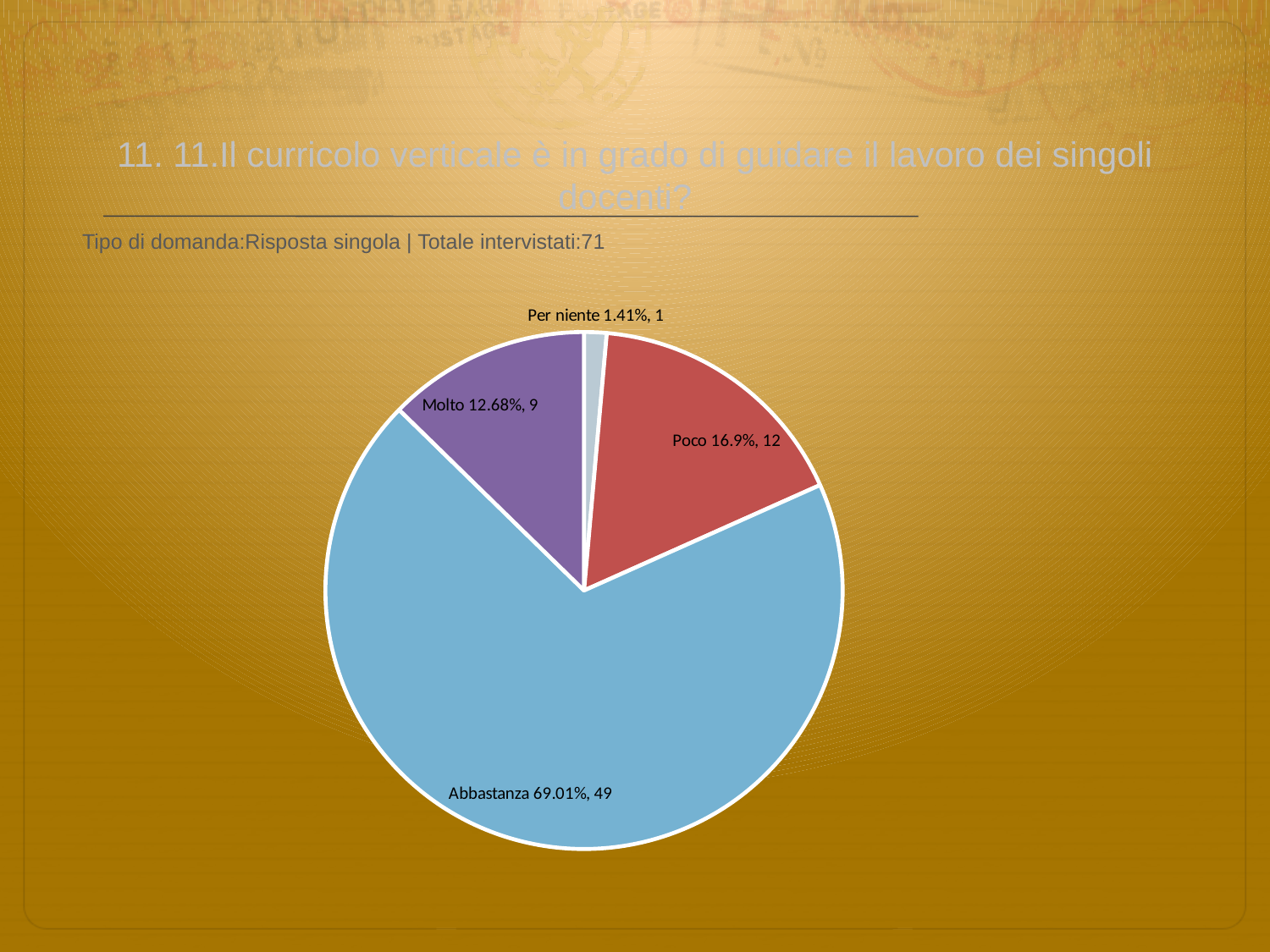
What percentage share does the Abbastanza slice have? 69.01% Which category has the largest slice? Abbastanza What percentage share does the Per niente slice have? 1.41% How many respondents answered Molto? 9 How many slices does the pie chart have? 4 What kind of chart is shown on the slide? pie chart How many respondents answered Poco? 12 What colour is the Abbastanza slice? light blue Which has more respondents, Poco or Molto? Poco What is the total number of respondents across all slices? 71 What is the difference in respondent count between Abbastanza and Poco? 37 Which category has the smallest slice? Per niente